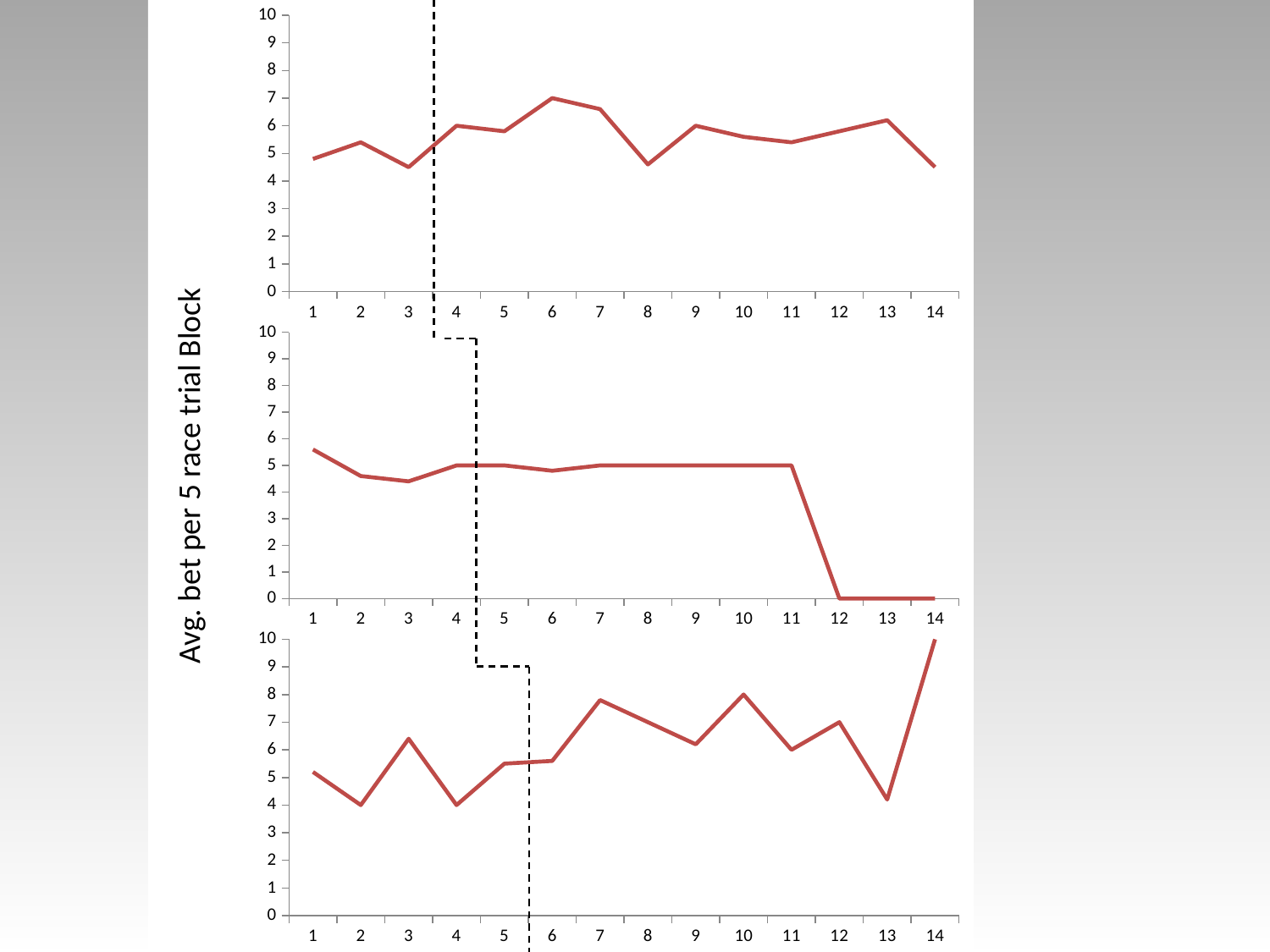
In the bottom chart, is the value at block 7 greater or less than 7? greater In the top chart, is the value at block 6 greater or less than 6? greater What kind of chart is the top chart on the slide? line chart In the middle chart, what is the value at block 12? 0 In the middle chart, which block has the highest value? 1 In the bottom chart, which block has the highest value? 14 In the bottom chart, what is the value at block 14? 10 In the middle chart, which is larger, the value at block 11 or the value at block 12? block 11 In the bottom chart, which is larger, the value at block 10 or the value at block 13? block 10 In the top chart, is the value at block 8 greater or less than 5? less What is the label on the vertical axis shared by the charts? Avg. bet per 5 race trial Block How many trial blocks are plotted along the x axis of the middle chart? 14